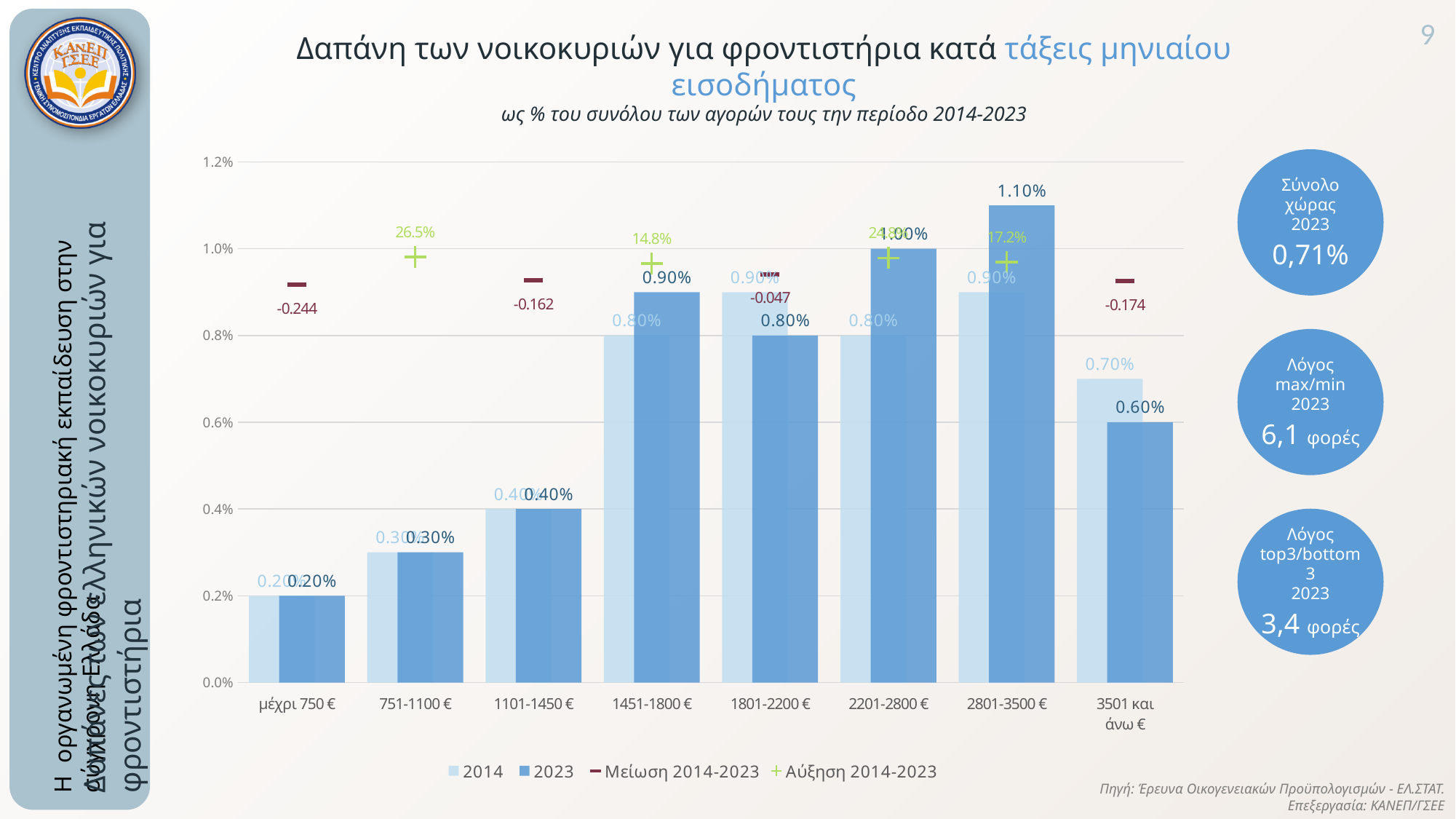
Which income class has the highest 2023 value? 2801-3500 € What is the Αύξηση 2014-2023 value shown for the 751-1100 € income class? 26.5% What kind of chart is used to show the 2014 and 2023 values? Bar chart What is the 2014 value for the 3501 και άνω € income class? 0.70% What is the Μείωση 2014-2023 value shown for the μέχρι 750 € income class? -0.244 What is the 2023 value for the 1451-1800 € income class? 0.90% For the 1801-2200 € income class, which is larger, the 2014 value or the 2023 value? 2014 How many entries does the legend list? 4 What is the 2023 value for the 2801-3500 € income class? 1.10% Which income class has the lowest 2014 value? μέχρι 750 € How many income classes are shown on the x axis? 8 What is the difference between the 2023 and 2014 values for the 2201-2800 € income class? 0.20%